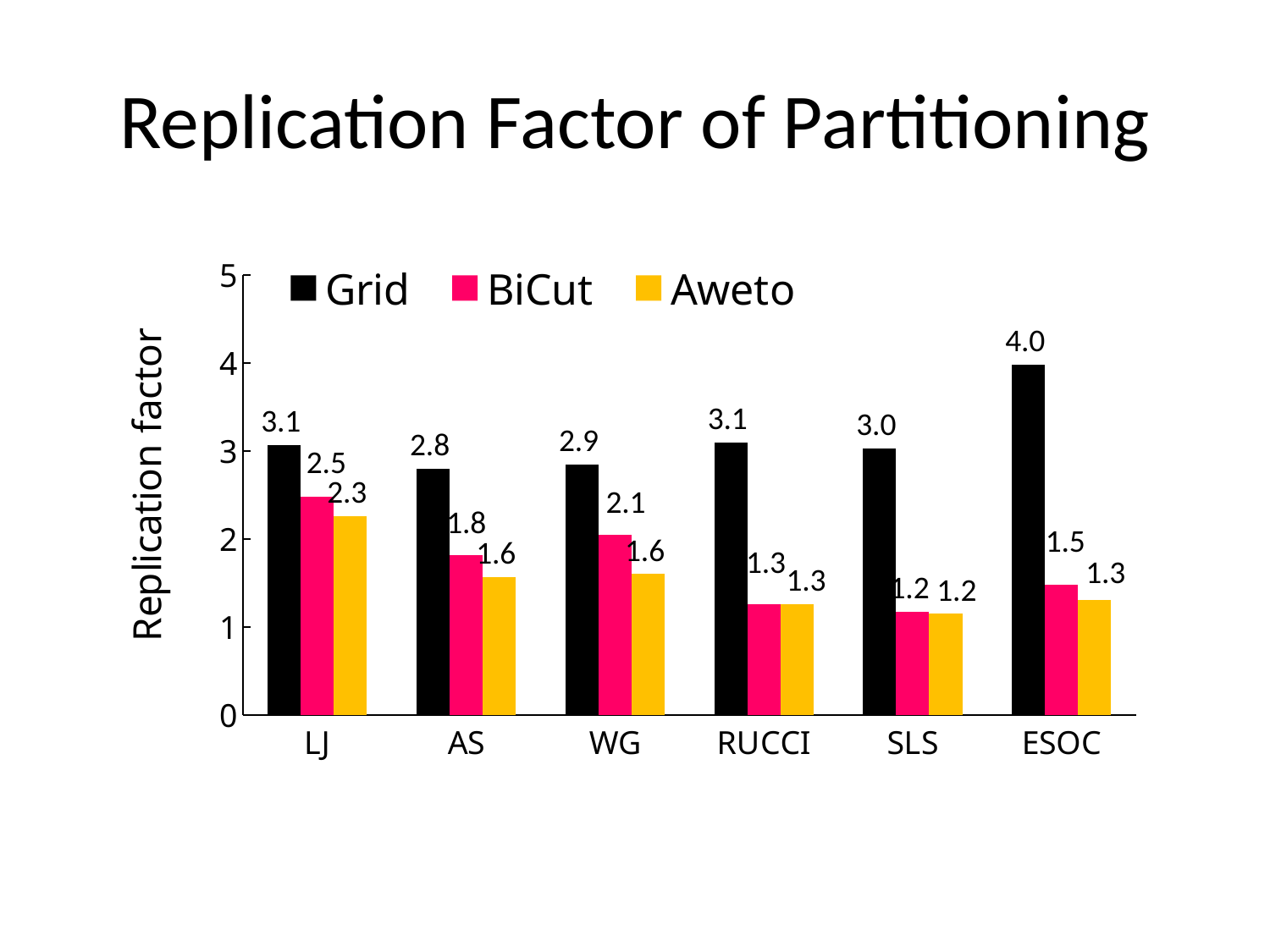
How many series does the legend list? 3 Which dataset has the lowest BiCut replication factor? SLS What kind of chart is shown on the slide? Bar chart What is the difference between the Grid and Aweto replication factors on the ESOC dataset? 2.7 What is the replication factor for Grid on the ESOC dataset? 4.0 What is the replication factor for Aweto on the WG dataset? 1.6 Which dataset has the highest Grid replication factor? ESOC Is the Grid replication factor for WG greater or less than 2? greater What is the label of the y axis? Replication factor Which is larger on the AS dataset, the BiCut or the Aweto replication factor? BiCut How many datasets are shown on the x axis? 6 What is the replication factor for BiCut on the LJ dataset? 2.5